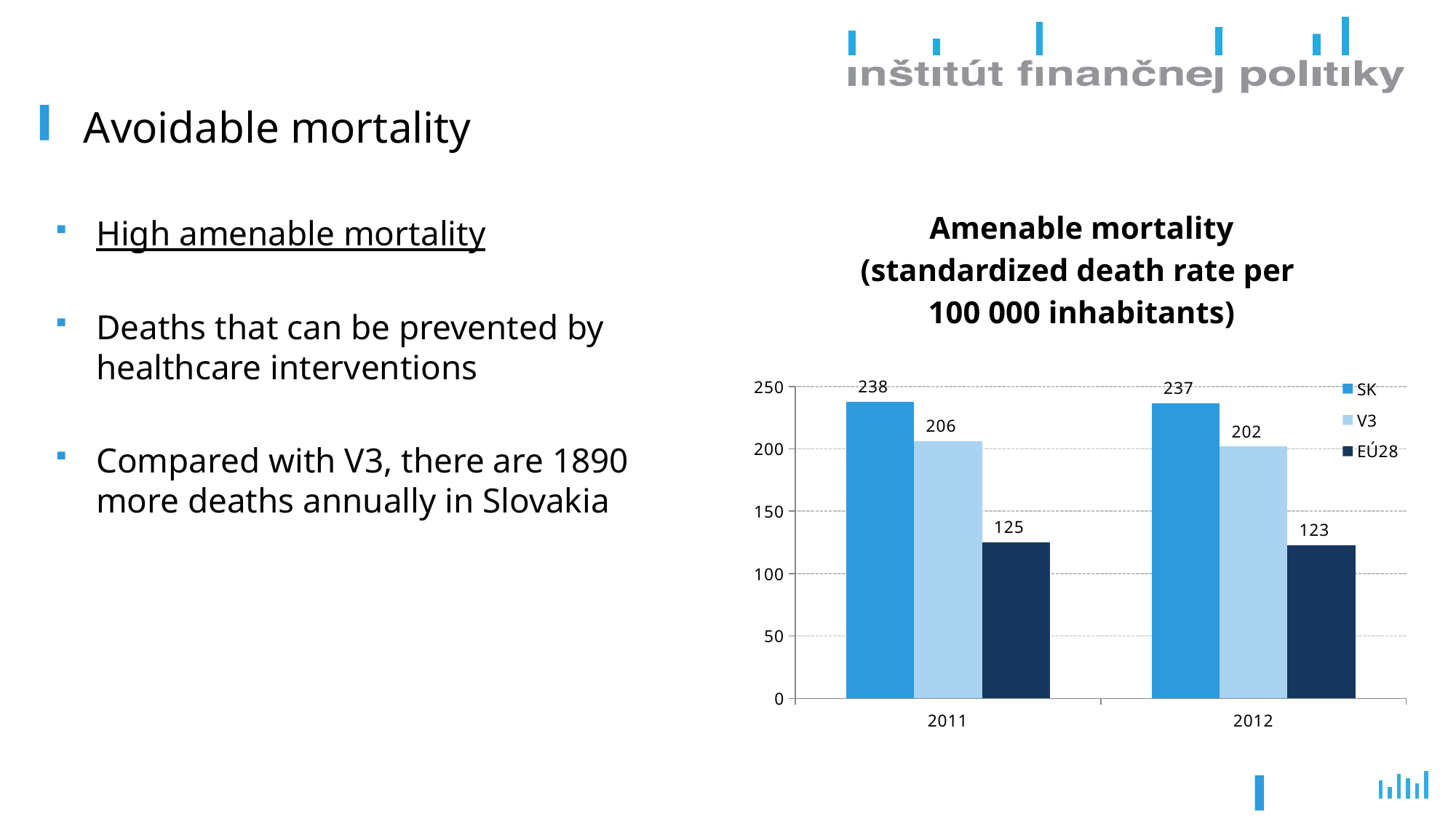
Which series has the lowest value in 2011? EÚ28 Which series has the highest value in 2012? SK What kind of chart is shown on the slide? Bar chart What is the value for V3 in 2012? 202 What is the value for EÚ28 in 2011? 125 How many series does the legend list? 3 What is the value for SK in 2011? 238 Which is larger, the SK value in 2011 or the SK value in 2012? SK in 2011 How many year categories are shown on the x axis? 2 What is the difference between the SK and V3 values in 2011? 32 What is the difference between the V3 and EÚ28 values in 2012? 79 Does the EÚ28 value rise or fall from 2011 to 2012? Fall